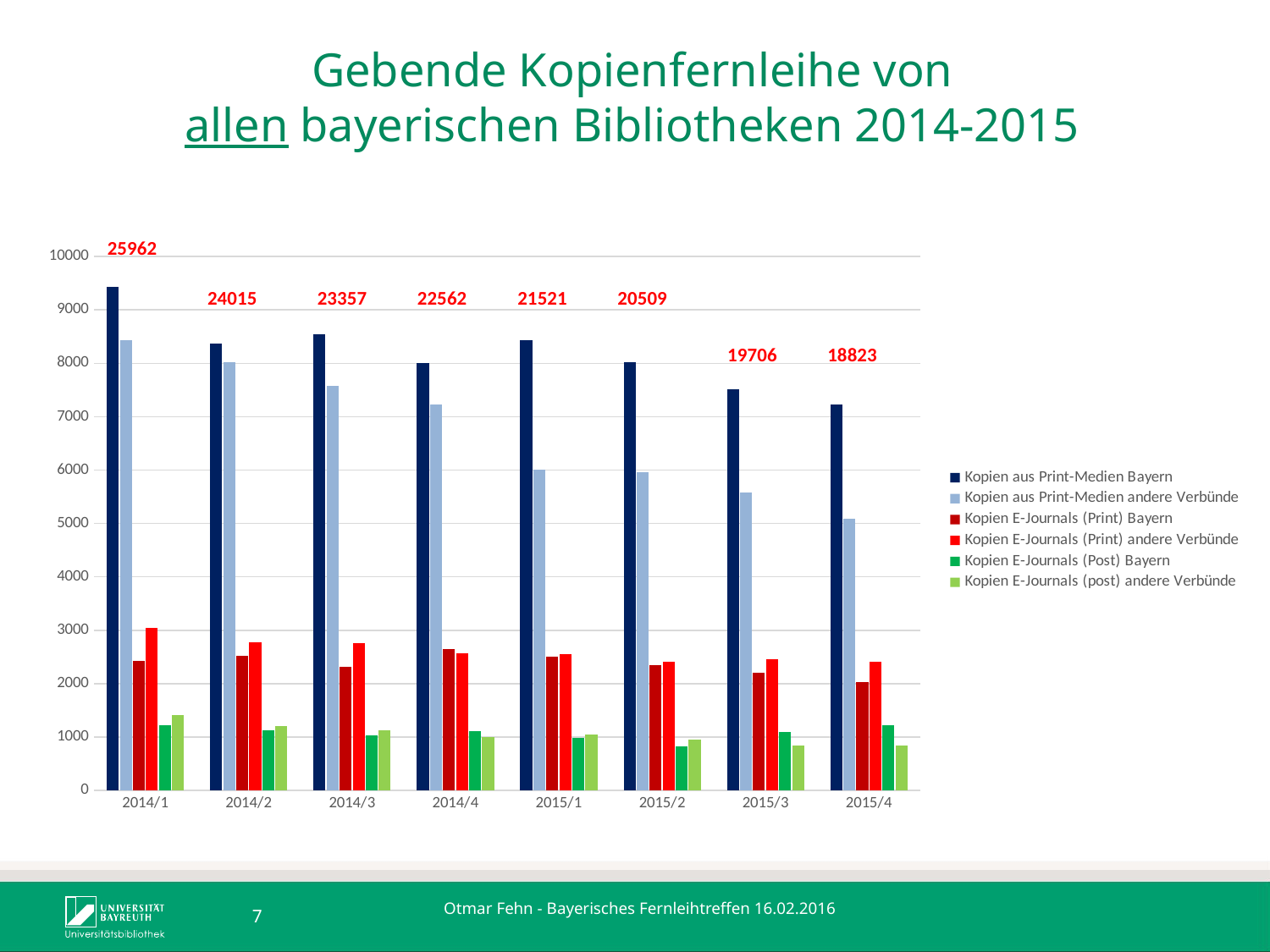
How many series does the chart's legend list? 6 In 2014/1, which is larger: Kopien aus Print-Medien Bayern or Kopien aus Print-Medien andere Verbünde? Kopien aus Print-Medien Bayern How many quarters (categories) are shown on the x axis of the chart? 8 What total value is printed in red above the 2015/2 group? 20509 What total value is printed in red above the 2015/4 group? 18823 Which quarter has the lowest printed total value? 2015/4 What total value is printed in red above the 2014/1 group? 25962 What is the difference between the printed totals for 2014/1 and 2015/4? 7139 Is the value for Kopien aus Print-Medien Bayern in 2014/1 greater or less than 9000? greater What kind of chart is shown on the slide? bar chart Which quarter has the highest printed total value? 2014/1 Do the printed total values rise or fall from 2014/1 to 2015/4? fall